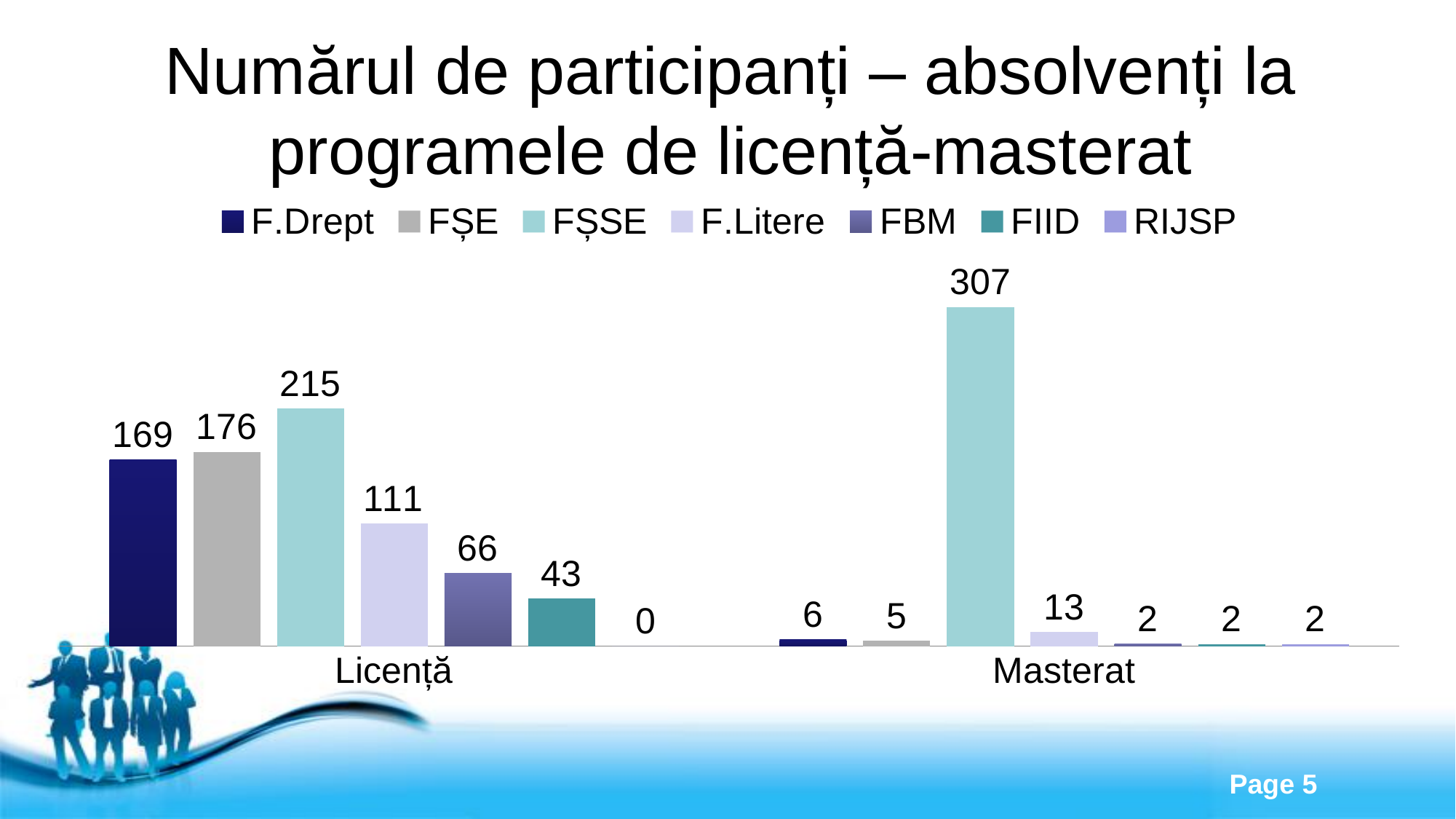
What is the value for FȘSE in the Masterat category? 307 How many series does the legend list? 7 How many categories are shown on the x axis? 2 Which is larger in the Licență category, FȘE or F.Drept? FȘE Which series has the highest value in the Licență category? FȘSE What is the value for RIJSP in the Licență category? 0 What is the difference between the FBM and FIID values in the Licență category? 23 What is the value for F.Drept in the Licență category? 169 What is the difference between the FȘSE values for Masterat and Licență? 92 What is the value for F.Litere in the Masterat category? 13 What kind of chart is shown on the slide? Bar chart Which series has the lowest value in the Licență category? RIJSP